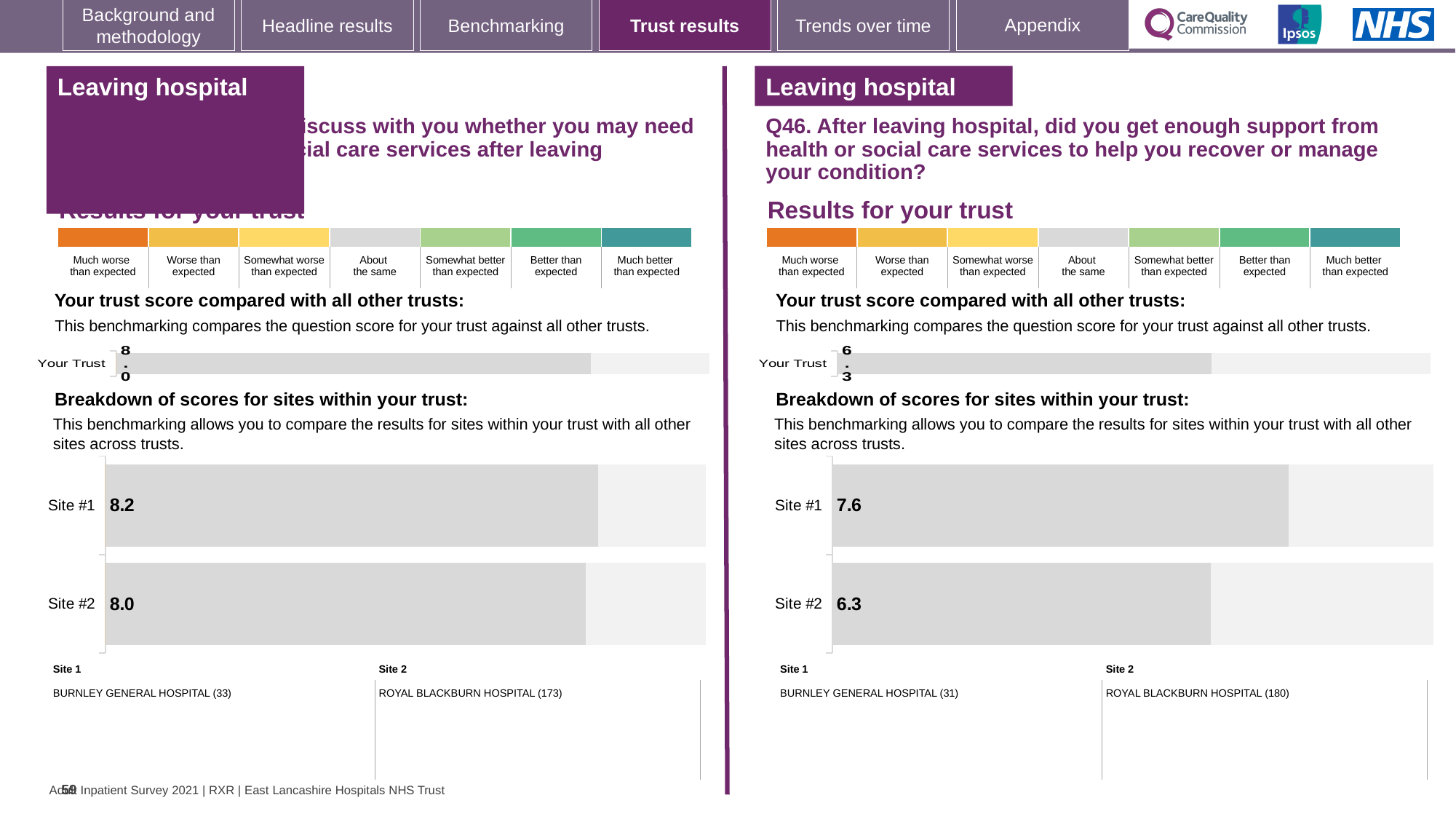
In the site breakdown chart on the left-hand side of the slide, what is the difference between the Site #1 and Site #2 scores? 0.2 How many sites are shown in the Q46 site breakdown chart on the right? 2 What type of chart is used for the site breakdown on the right-hand side of the slide? Bar chart In the 'Your Trust' bar chart on the left-hand side of the slide, what is the trust score? 8.0 In the Q46 site breakdown chart on the right, which site has the higher score? Site #1 In the Q46 site breakdown chart on the right, what is the difference between the Site #1 and Site #2 scores? 1.3 In the Q46 site breakdown chart on the right, what is the score for Site #2? 6.3 In the Q46 'Your Trust' bar chart on the right, what is the trust score? 6.3 In the site breakdown chart on the left-hand side of the slide, what is the score for Site #1? 8.2 In the site breakdown chart on the left-hand side of the slide, what is the score for Site #2? 8.0 In the Q46 site breakdown chart on the right, what is the score for Site #1? 7.6 Is the Site #2 score in the left-hand site breakdown chart larger or smaller than the Site #2 score in the right-hand Q46 chart? Larger